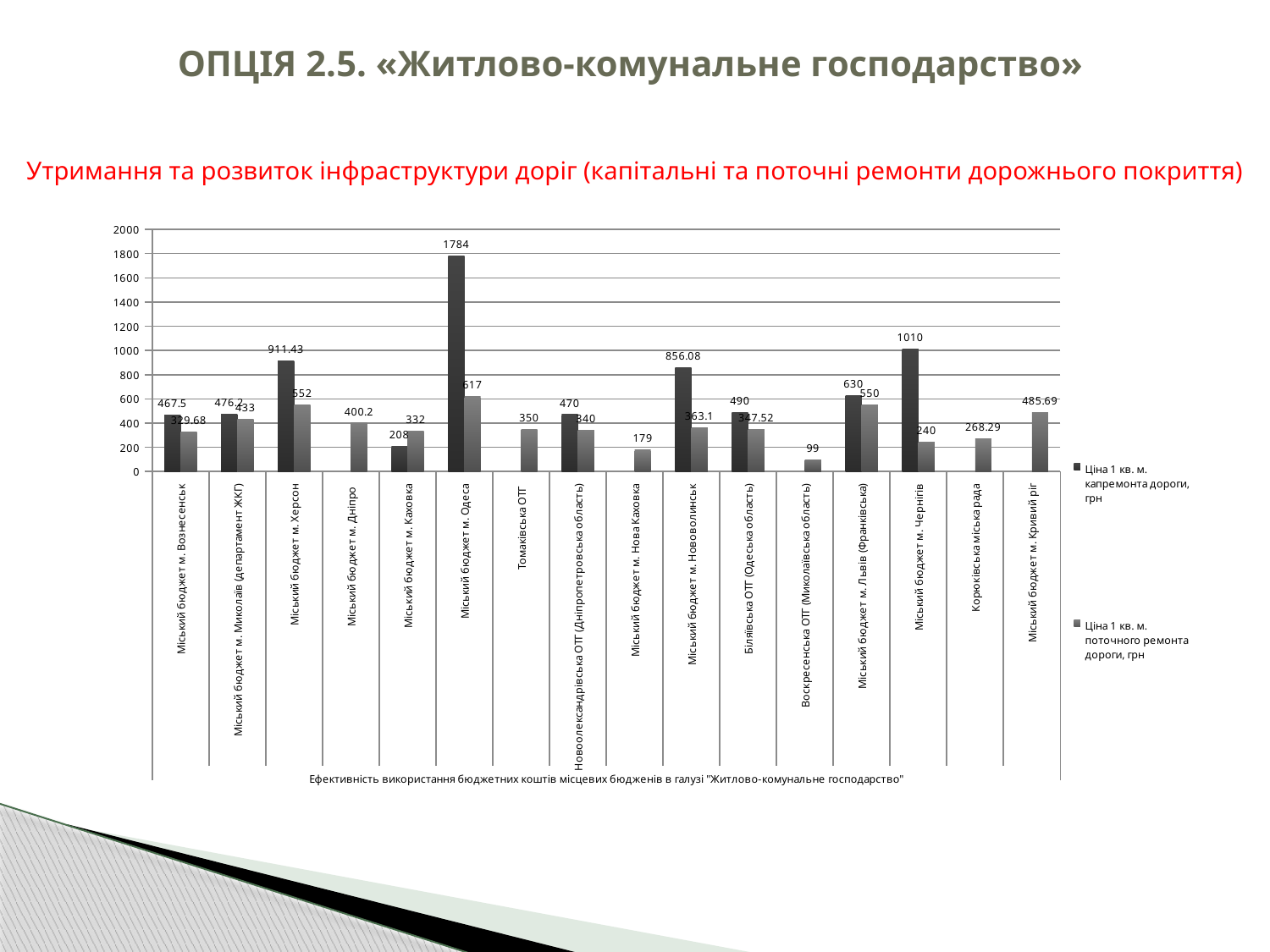
What is the title of the horizontal axis of the chart? Ефективність використання бюджетних коштів місцевих бюдженів в галузі "Житлово-комунальне господарство" What type of chart is shown on the slide? Bar chart What is the value of 'Ціна 1 кв. м. капремонта дороги, грн' for Міський бюджет м. Одеса? 1784 What is the value of 'Ціна 1 кв. м. поточного ремонта дороги, грн' for Міський бюджет м. Кривий ріг? 485.69 Which category has the highest value for 'Ціна 1 кв. м. капремонта дороги, грн'? Міський бюджет м. Одеса What is the difference between the 'Ціна 1 кв. м. капремонта дороги, грн' values for Міський бюджет м. Одеса and Міський бюджет м. Чернігів? 774 Which category has the lowest value for 'Ціна 1 кв. м. поточного ремонта дороги, грн'? Воскресенська ОТГ (Миколаївська область) How many series does the legend list? 2 Which is larger for Міський бюджет м. Каховка: the капремонт value or the поточний ремонт value? Поточний ремонт (332) What is the value of 'Ціна 1 кв. м. капремонта дороги, грн' for Міський бюджет м. Херсон? 911.43 How many categories are shown on the x axis of the chart? 16 Is the 'Ціна 1 кв. м. капремонта дороги, грн' value for Міський бюджет м. Нововолинськ greater or less than 800? greater